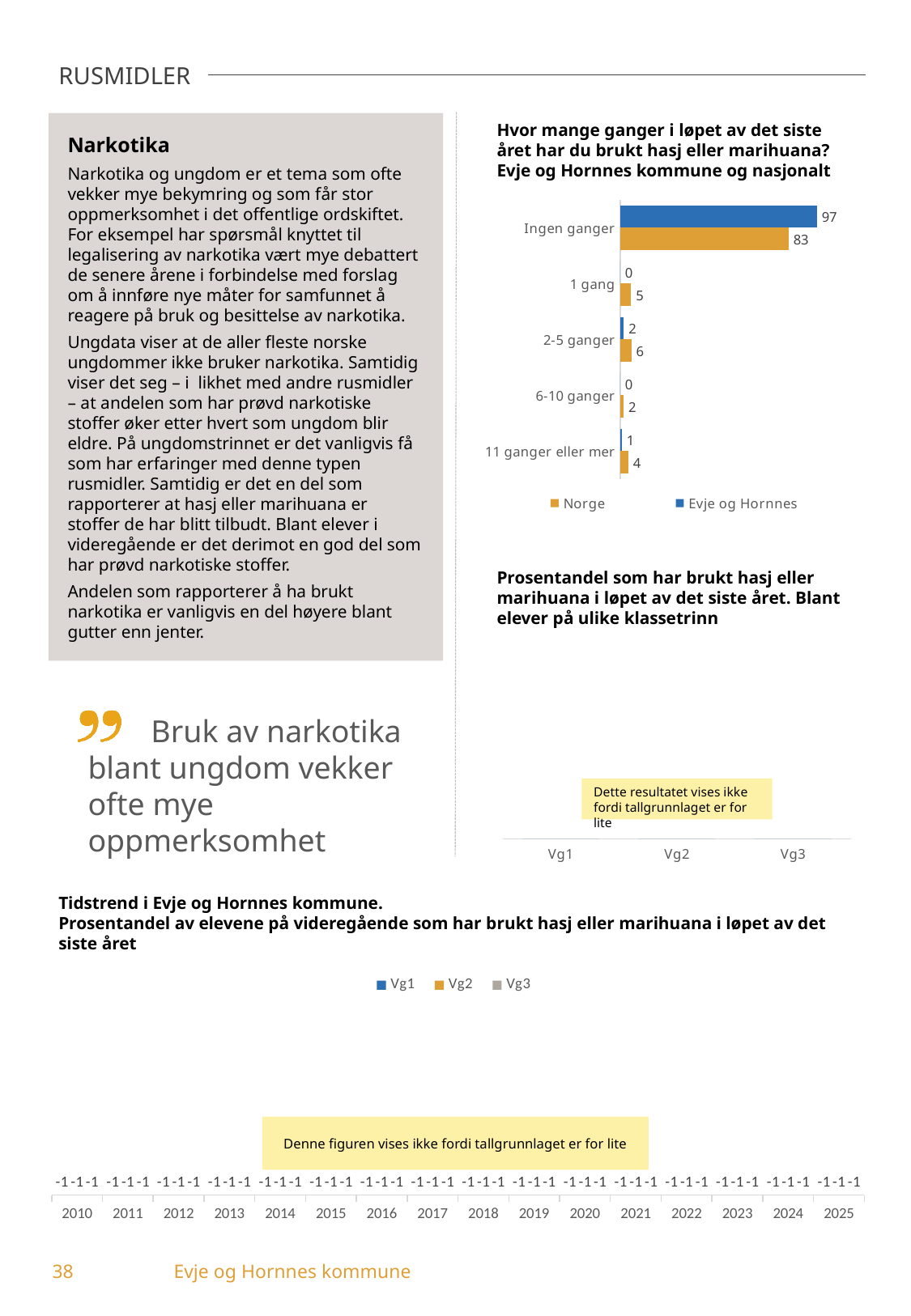
In the chart 'Hvor mange ganger i løpet av det siste året har du brukt hasj eller marihuana?', which colour represents Norge? Orange In the chart 'Hvor mange ganger i løpet av det siste året har du brukt hasj eller marihuana?', what is the value for Evje og Hornnes for '11 ganger eller mer'? 1 In the chart 'Hvor mange ganger i løpet av det siste året har du brukt hasj eller marihuana?', which is larger for '1 gang': Norge or Evje og Hornnes? Norge In the chart 'Hvor mange ganger i løpet av det siste året har du brukt hasj eller marihuana?', what is the value for Norge for 'Ingen ganger'? 83 In the chart 'Hvor mange ganger i løpet av det siste året har du brukt hasj eller marihuana?', what is the value for Evje og Hornnes for 'Ingen ganger'? 97 In the chart 'Hvor mange ganger i løpet av det siste året har du brukt hasj eller marihuana?', what is the value for Norge for '2-5 ganger'? 6 In the chart 'Hvor mange ganger i løpet av det siste året har du brukt hasj eller marihuana?', how many series does the legend list? 2 What kind of chart is 'Hvor mange ganger i løpet av det siste året har du brukt hasj eller marihuana?'? Bar chart In the chart 'Hvor mange ganger i løpet av det siste året har du brukt hasj eller marihuana?', what is the difference between Norge and Evje og Hornnes for '2-5 ganger'? 4 In the chart 'Hvor mange ganger i løpet av det siste året har du brukt hasj eller marihuana?', what is the difference between Evje og Hornnes and Norge for 'Ingen ganger'? 14 In the chart 'Hvor mange ganger i løpet av det siste året har du brukt hasj eller marihuana?', which category has the highest value for Norge? Ingen ganger In the chart 'Hvor mange ganger i løpet av det siste året har du brukt hasj eller marihuana?', how many categories are shown? 5